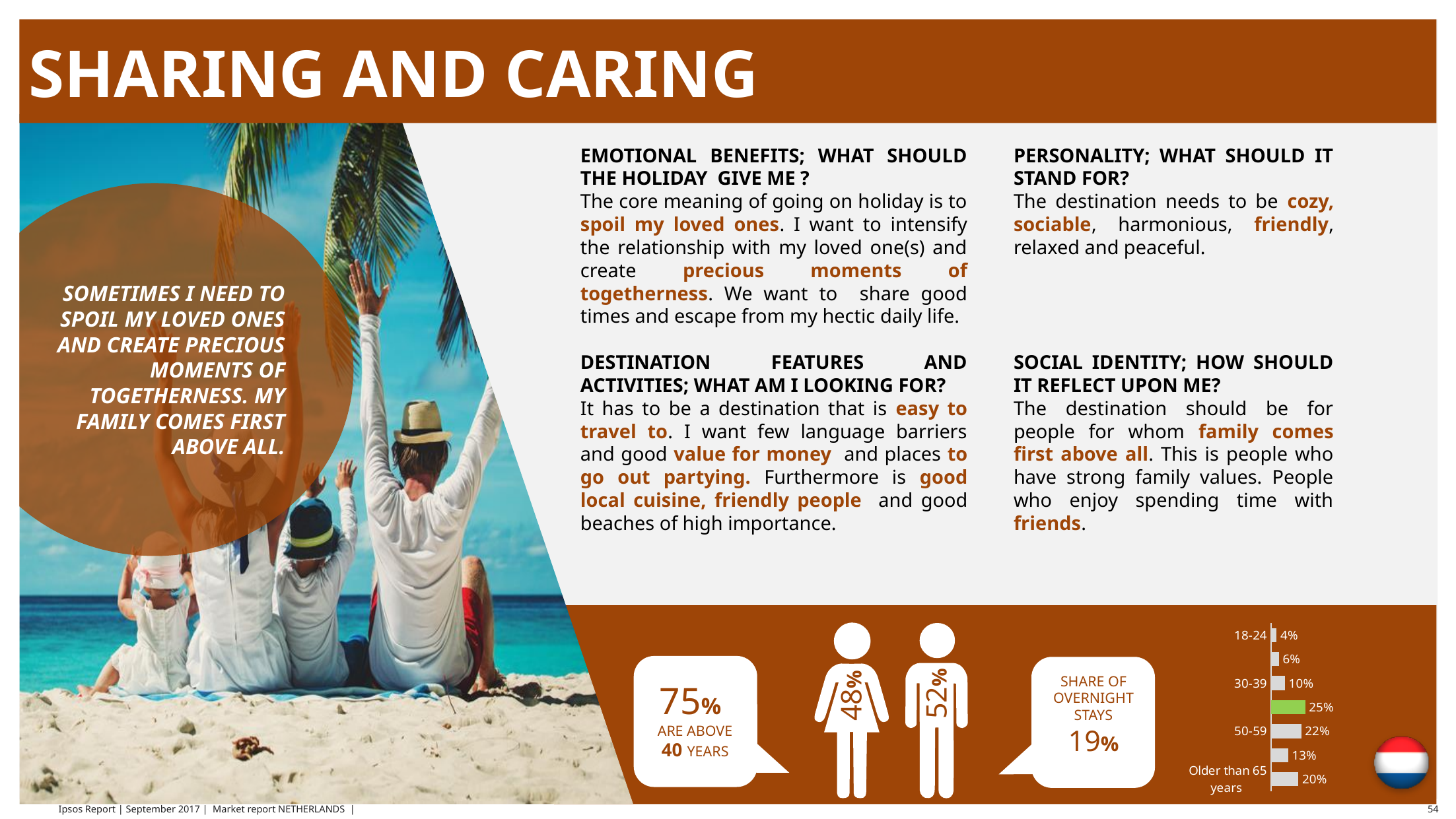
In the age-group bar chart, what is the value of the bar highlighted in green? 25% In the age-group bar chart, what is the difference between the values for 50-59 and 30-39? 12% In the age-group bar chart, what is the difference between the values for Older than 65 years and 18-24? 16% In the age-group bar chart, which of the labelled age groups has the lowest value? 18-24 In the age-group bar chart, what is the highest value shown on any bar? 25% In the age-group bar chart, what is the value for 30-39? 10% In the age-group bar chart, which is larger: the value for 50-59 or the value for Older than 65 years? 50-59 In the age-group bar chart, what is the value for Older than 65 years? 20% How many bars does the age-group bar chart contain? 7 In the age-group bar chart, what is the value for 18-24? 4% What kind of chart is shown at the bottom right of the slide? bar chart In the age-group bar chart, what is the value for 50-59? 22%